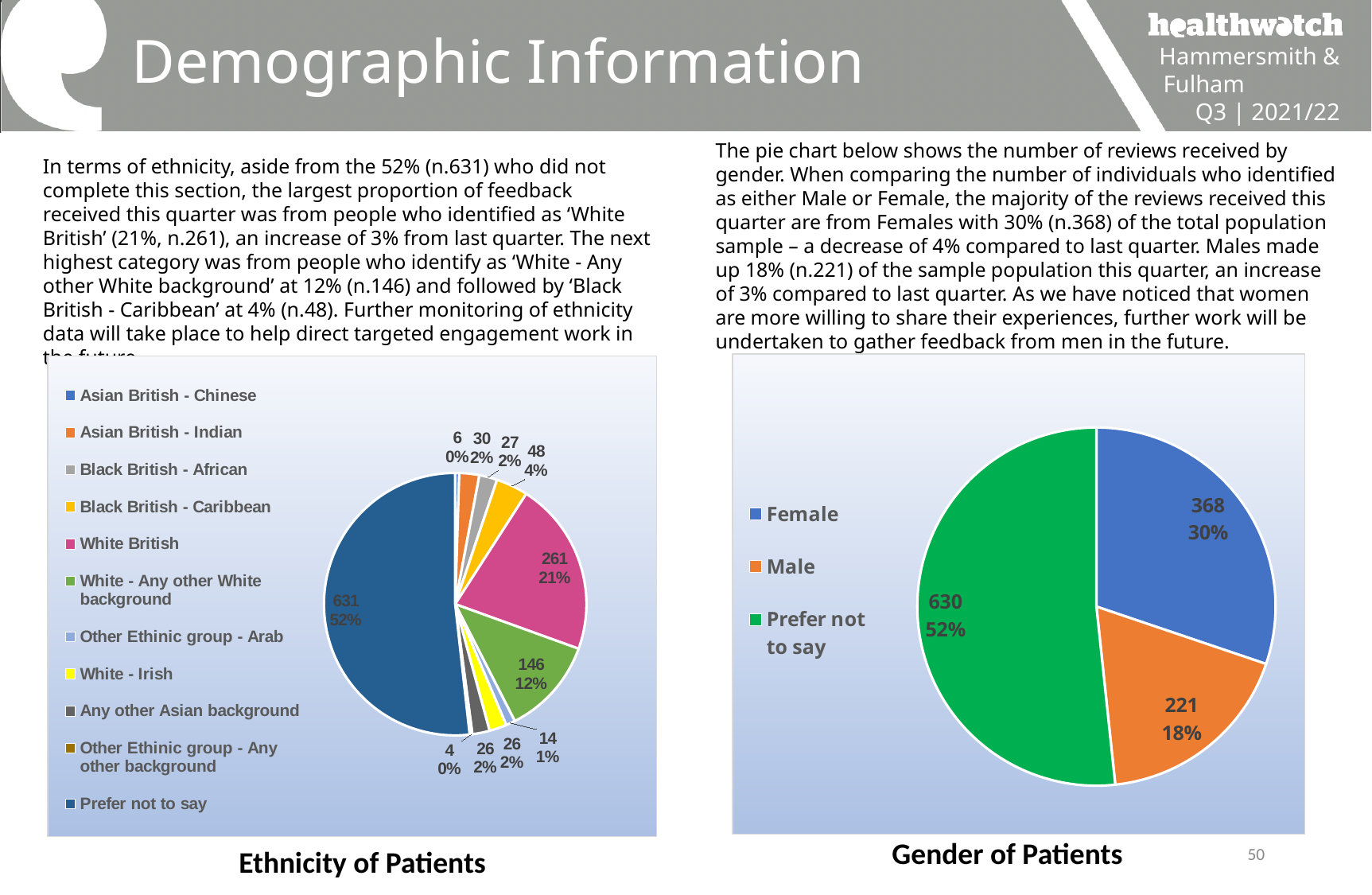
How many categories does the legend of the Gender of Patients chart list? 3 In the Gender of Patients chart, what percentage share does Male represent? 18% In the Gender of Patients chart, which category has the largest slice? Prefer not to say In the Ethnicity of Patients chart, which is larger: Black British - Caribbean or Black British - African? Black British - Caribbean In the Ethnicity of Patients chart, what percentage share does 'White - Any other White background' represent? 12% In the Gender of Patients chart, how many reviews were from Female patients? 368 In the Gender of Patients chart, which category has the smallest slice? Male What type of chart is the Ethnicity of Patients chart? Pie chart How many categories does the legend of the Ethnicity of Patients chart list? 11 In the Ethnicity of Patients chart, which category has the largest slice? Prefer not to say In the Gender of Patients chart, what is the difference between the Female and Male counts? 147 In the Ethnicity of Patients chart, what is the value for White British? 261